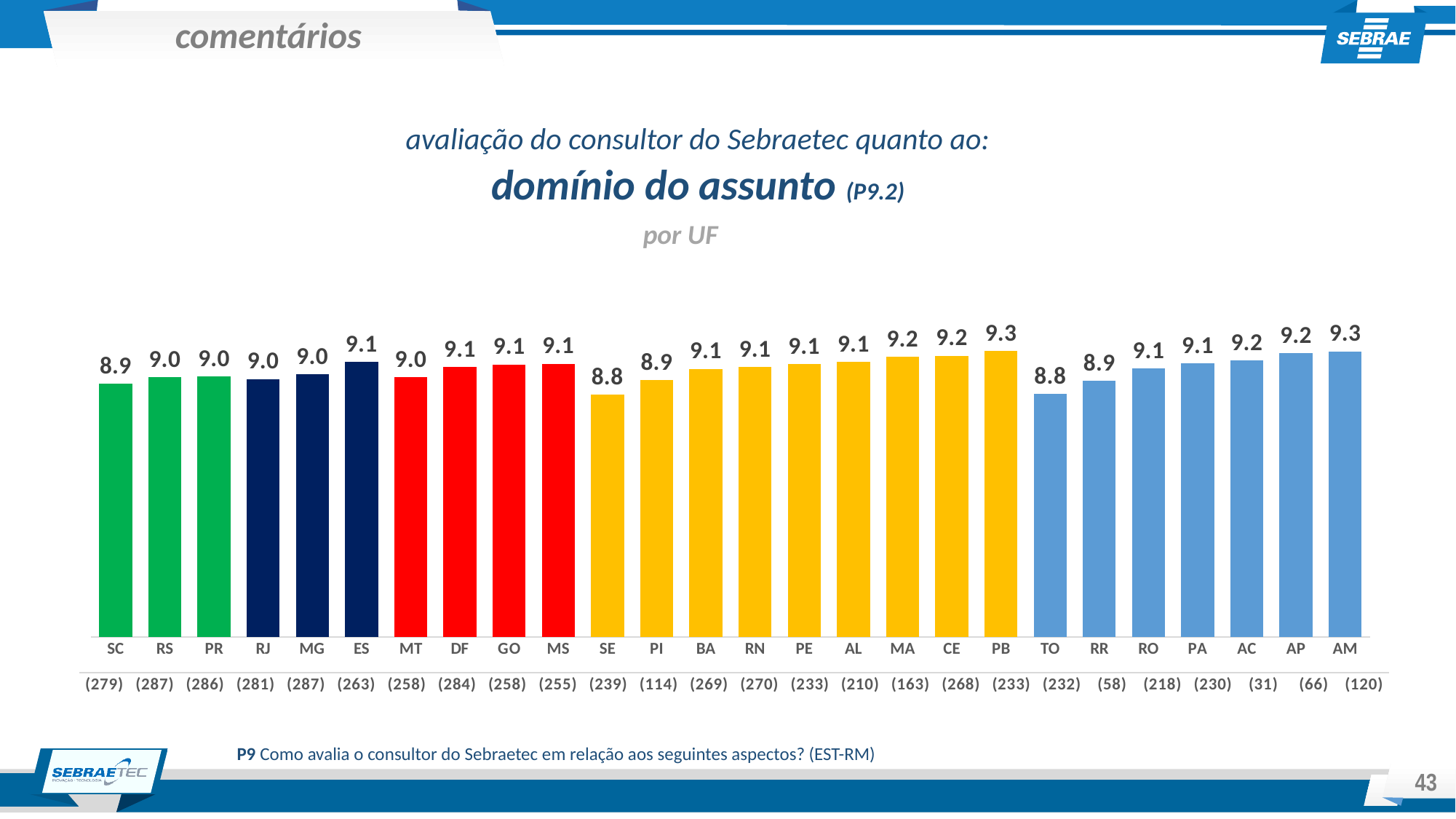
What is the difference between the values for MA and SC? 0.3 Which has a larger value, ES or TO? ES What is the value for PB? 9.3 What is the highest value shown on the chart? 9.3 What is the value for MG? 9.0 What is the lowest value shown on the chart? 8.8 How many UFs (bars) are shown on the chart? 26 What is the value for AC? 9.2 What is the value for SE? 8.8 What kind of chart is shown on the slide? Bar chart What is the difference between the values for PB and SE? 0.5 What number is shown in parentheses below the RR bar? (58)